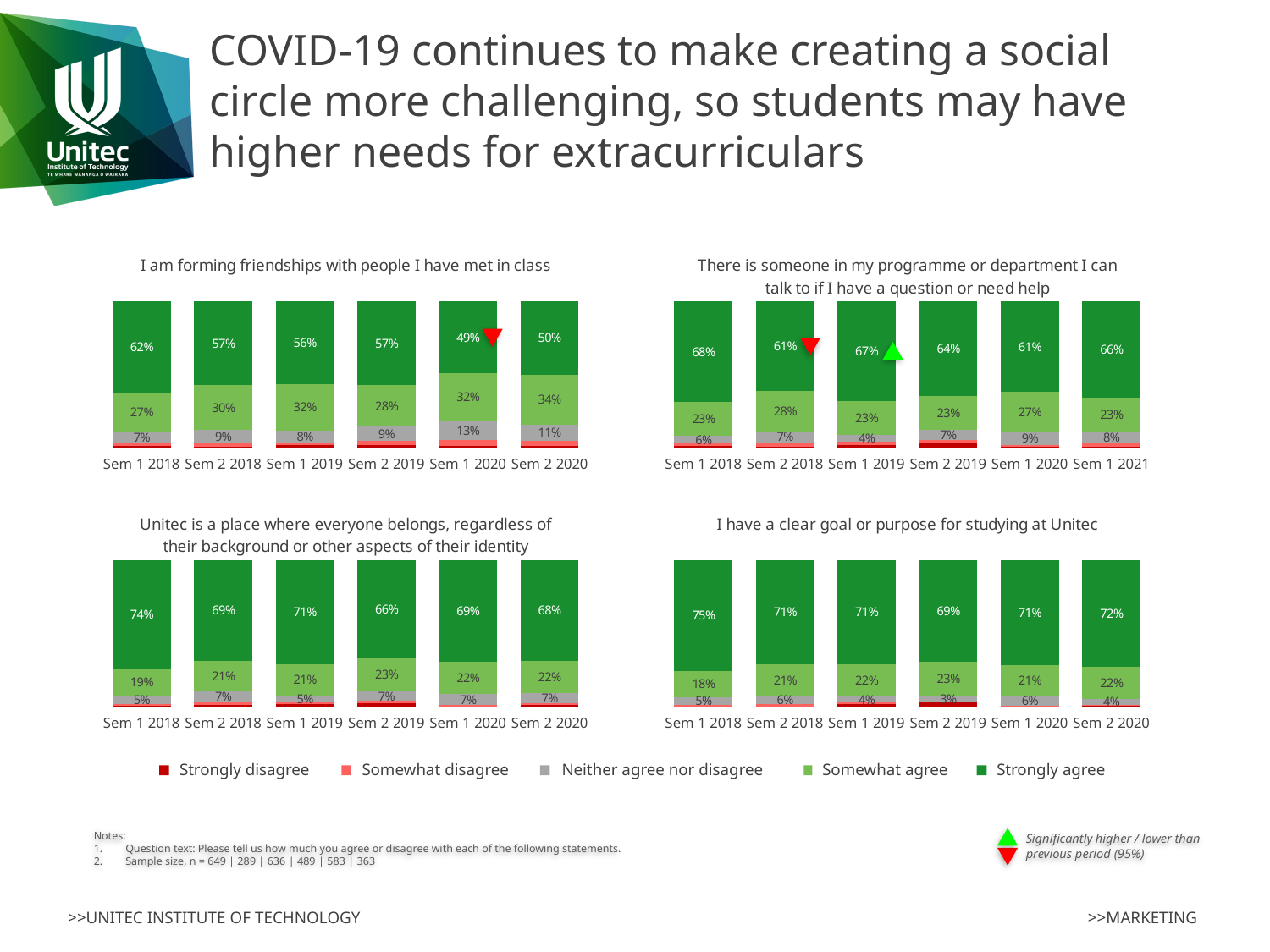
In the chart 'There is someone in my programme or department I can talk to if I have a question or need help', which semester has the highest Strongly agree value? Sem 1 2018 In the chart 'I am forming friendships with people I have met in class', what is the difference between the Strongly agree values for Sem 1 2018 and Sem 2 2020? 12% How many series does the shared legend list? 5 In the chart 'I have a clear goal or purpose for studying at Unitec', what is the Neither agree nor disagree value for Sem 2 2019? 3% In the chart 'I have a clear goal or purpose for studying at Unitec', what is the difference between the Strongly agree values for Sem 1 2018 and Sem 2 2019? 6% In the chart 'There is someone in my programme or department I can talk to if I have a question or need help', what is the label of the last semester on the x axis? Sem 1 2021 In the chart 'Unitec is a place where everyone belongs, regardless of their background or other aspects of their identity', what is the Strongly agree value for Sem 2 2019? 66% In the chart 'I am forming friendships with people I have met in class', what is the Strongly agree value for Sem 1 2018? 62% In the chart 'I am forming friendships with people I have met in class', which semester has the lowest Strongly agree value? Sem 1 2020 In the chart 'There is someone in my programme or department I can talk to if I have a question or need help', what is the Somewhat agree value for Sem 2 2018? 28% In the chart 'Unitec is a place where everyone belongs, regardless of their background or other aspects of their identity', is the Strongly agree value larger for Sem 1 2018 or Sem 2 2018? Sem 1 2018 What type of chart is used for 'I have a clear goal or purpose for studying at Unitec'? Stacked bar chart